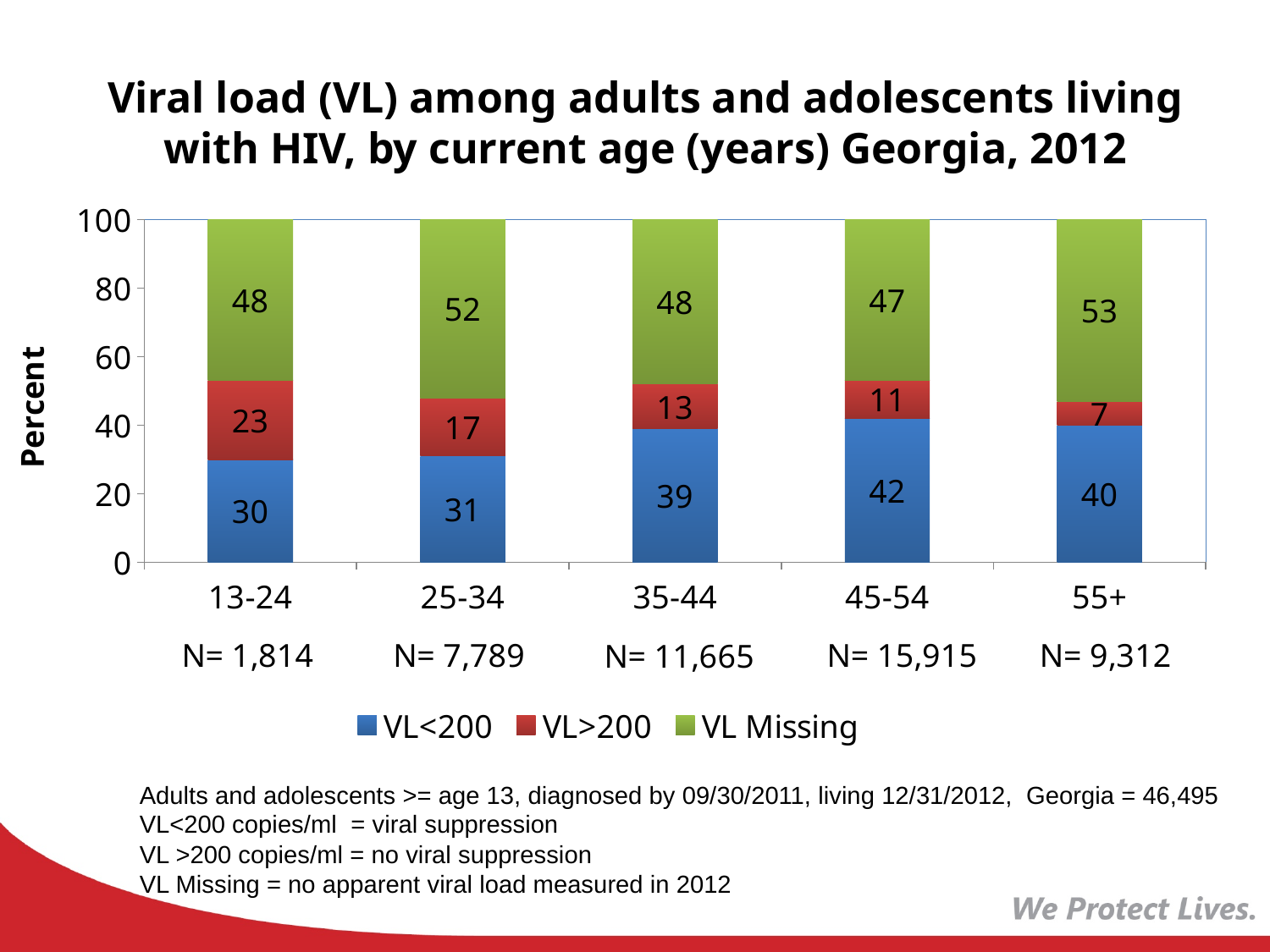
Which is larger, the VL Missing value for 25-34 or for 45-54? 25-34 What is the total of the stacked bar for the 25-34 age group? 100 What is the label of the y axis? Percent How many age groups are shown on the x axis? 5 What is the VL<200 value for the 35-44 age group? 39 What is the VL Missing value for the 55+ age group? 53 What is the difference between the VL>200 values for the 13-24 and 55+ age groups? 16 How many series does the legend list? 3 Which age group has the highest VL<200 value? 45-54 What is the VL>200 value for the 13-24 age group? 23 Which age group has the lowest VL>200 value? 55+ What kind of chart is shown on the slide? Stacked bar chart